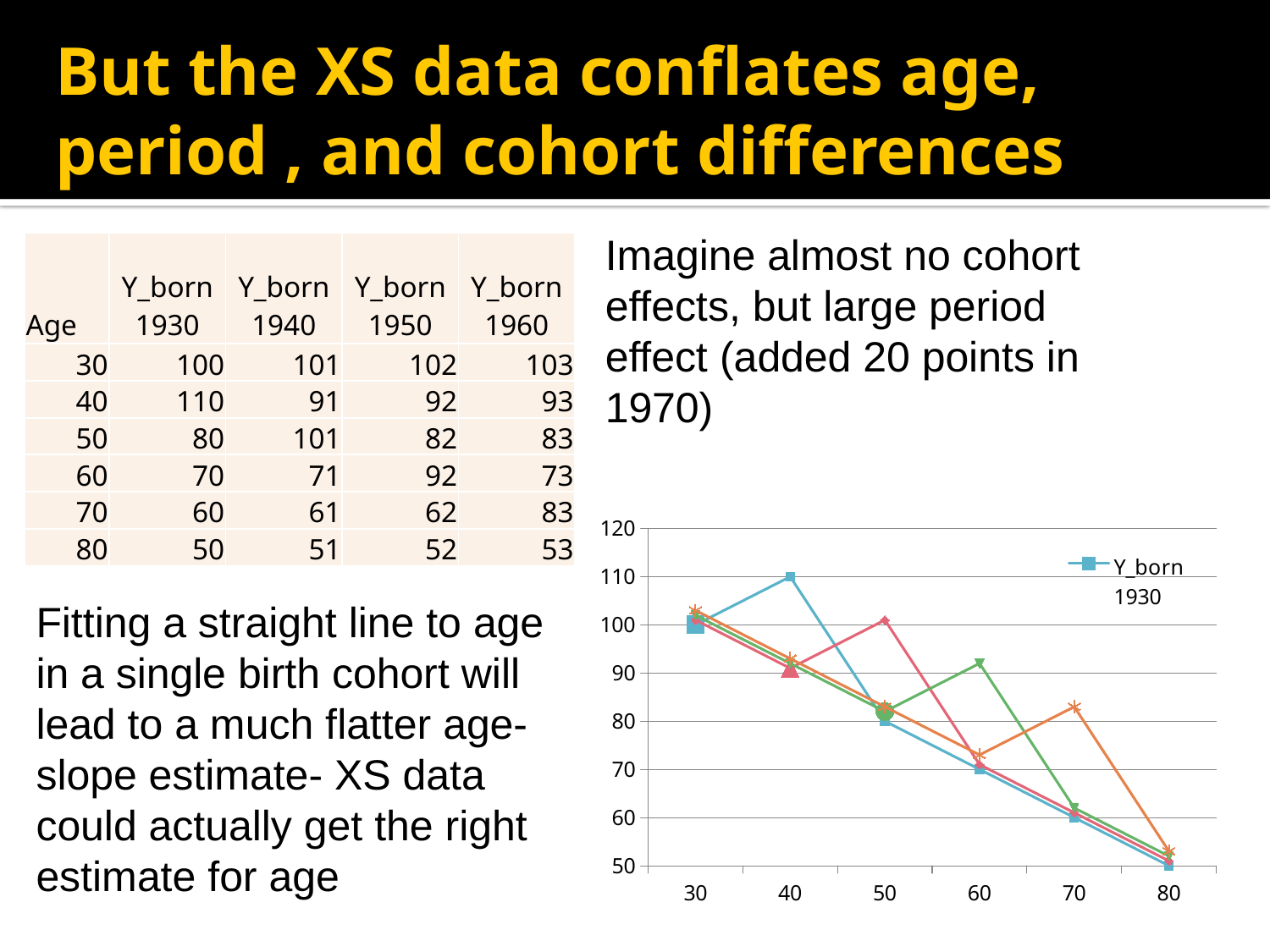
What is the difference between the Y_born 1930 values at age 40 and age 80? 60 What is the value of the Y_born 1930 series at age 40 in the chart? 110 At which age does the Y_born 1930 series reach its highest value in the chart? 40 What is the value of the Y_born 1930 series at age 30 in the chart? 100 At which age does the Y_born 1930 series reach its lowest value in the chart? 80 What kind of chart is shown on the slide? line chart How many age categories are shown on the x axis of the chart? 6 What is the value of the Y_born 1930 series at age 80 in the chart? 50 Which series name is readable in the chart's legend? Y_born 1930 Which is larger for the Y_born 1930 series: the value at age 40 or the value at age 50? age 40 Do the values in the chart generally rise or fall as age increases from 30 to 80? fall Is the Y_born 1930 value at age 40 greater or less than 100? greater